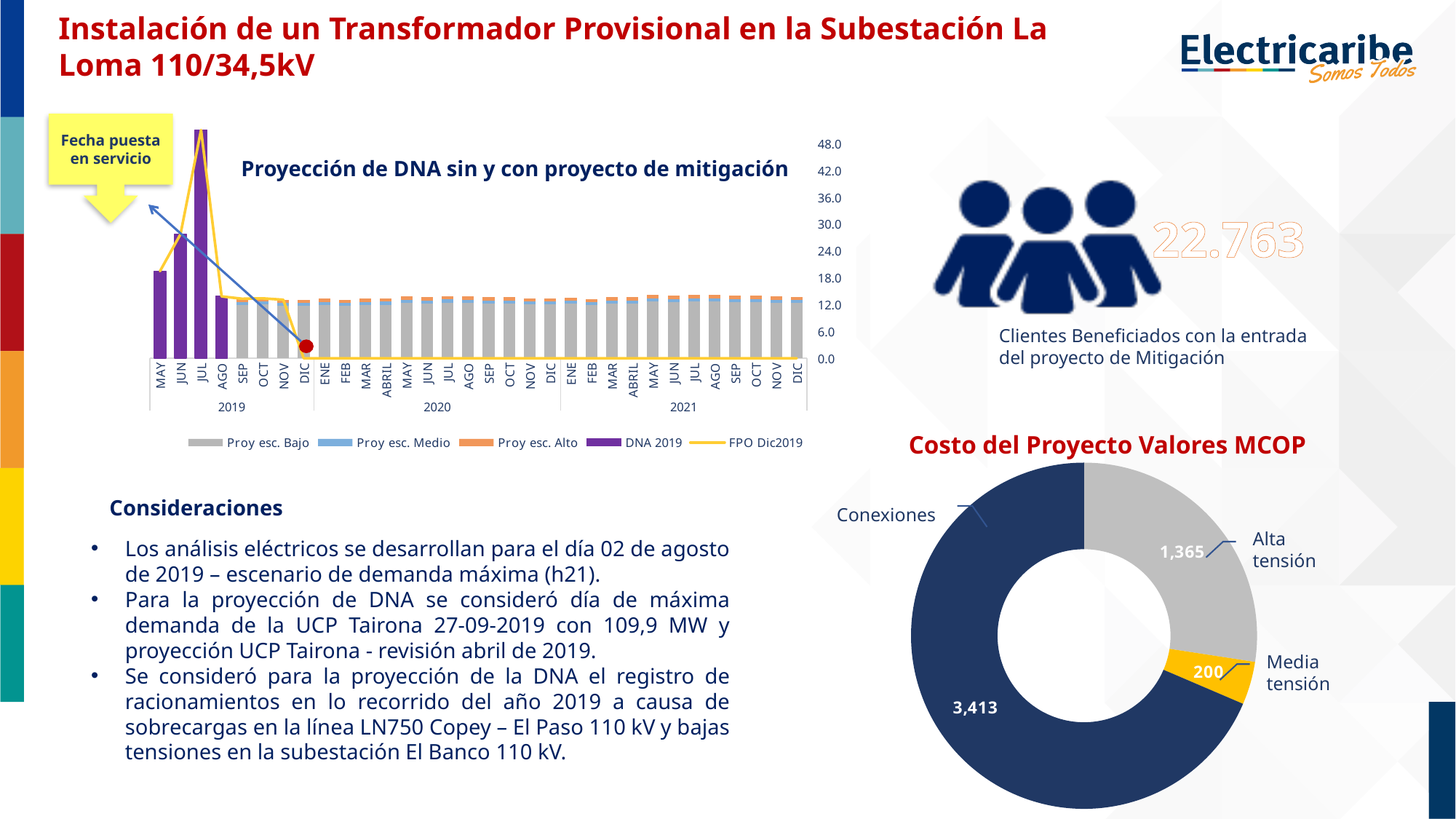
In the donut chart 'Costo del Proyecto Valores MCOP', what is the value for Alta tensión? 1,365 In the donut chart 'Costo del Proyecto Valores MCOP', which category has the largest value? Conexiones In the donut chart 'Costo del Proyecto Valores MCOP', which category has the smallest value? Media tensión In the chart 'Proyección de DNA sin y con proyecto de mitigación', how many series does the legend list? 5 In the donut chart 'Costo del Proyecto Valores MCOP', what is the value for Media tensión? 200 In the donut chart 'Costo del Proyecto Valores MCOP', what is the total of all three values? 4,978 In the chart 'Proyección de DNA sin y con proyecto de mitigación', is the DNA 2019 value for MAY 2019 greater or less than 24.0? less In the chart 'Proyección de DNA sin y con proyecto de mitigación', which month of 2019 has the highest DNA 2019 bar? JUL In the donut chart 'Costo del Proyecto Valores MCOP', how many categories are shown? 3 In the donut chart 'Costo del Proyecto Valores MCOP', what is the value for Conexiones? 3,413 In the donut chart 'Costo del Proyecto Valores MCOP', what is the difference between Conexiones and Alta tensión? 2,048 In the chart 'Proyección de DNA sin y con proyecto de mitigación', is the DNA 2019 value for JUL 2019 greater or less than 42.0? greater